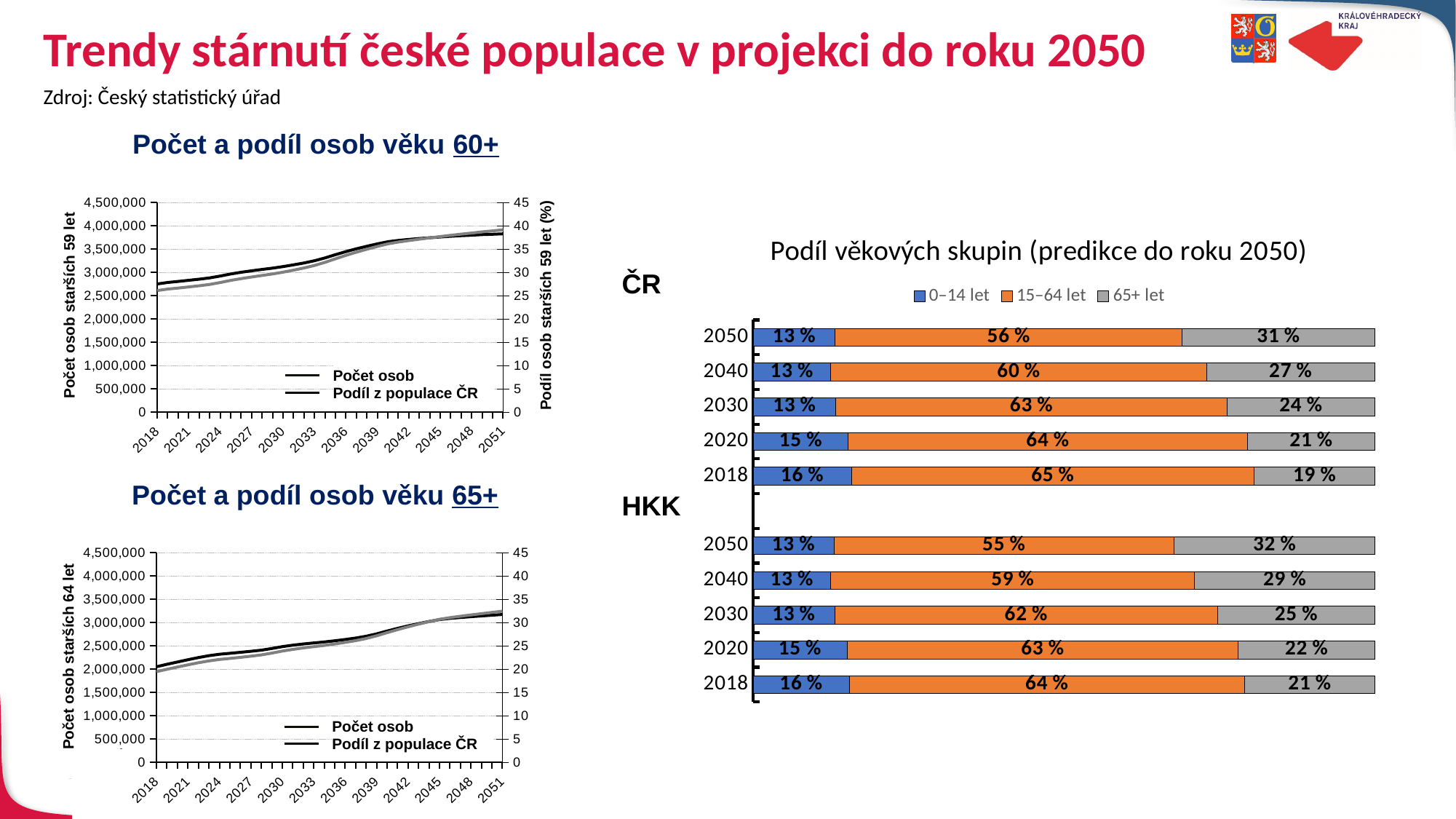
In the chart 'Podíl věkových skupin (predikce do roku 2050)', which has the larger 65+ let share in 2050, ČR or HKK? HKK In the chart 'Podíl věkových skupin (predikce do roku 2050)', what is the total of the three segments for ČR in 2020? 100 % In the chart 'Počet a podíl osob věku 60+', does the 'Počet osob' line rise or fall from 2018 to 2051? Rises In the chart 'Počet a podíl osob věku 65+', is the 'Počet osob' value in 2051 greater or less than 3,500,000? less In the chart 'Podíl věkových skupin (predikce do roku 2050)', what is the share of the 15–64 let group for HKK in 2018? 64 % In the chart 'Podíl věkových skupin (predikce do roku 2050)', which HKK year has the highest 65+ let share? 2050 In the chart 'Podíl věkových skupin (predikce do roku 2050)', which ČR year has the lowest 65+ let share? 2018 How many series does the legend of the chart 'Podíl věkových skupin (predikce do roku 2050)' list? 3 In the chart 'Podíl věkových skupin (predikce do roku 2050)', by how many percentage points does the ČR 65+ let share in 2050 exceed the ČR 65+ let share in 2018? 12 % In the chart 'Podíl věkových skupin (predikce do roku 2050)', what is the share of the 65+ let group for ČR in 2050? 31 % How many bars are plotted in the chart 'Podíl věkových skupin (predikce do roku 2050)'? 10 What kind of chart is 'Podíl věkových skupin (predikce do roku 2050)'? Stacked bar chart